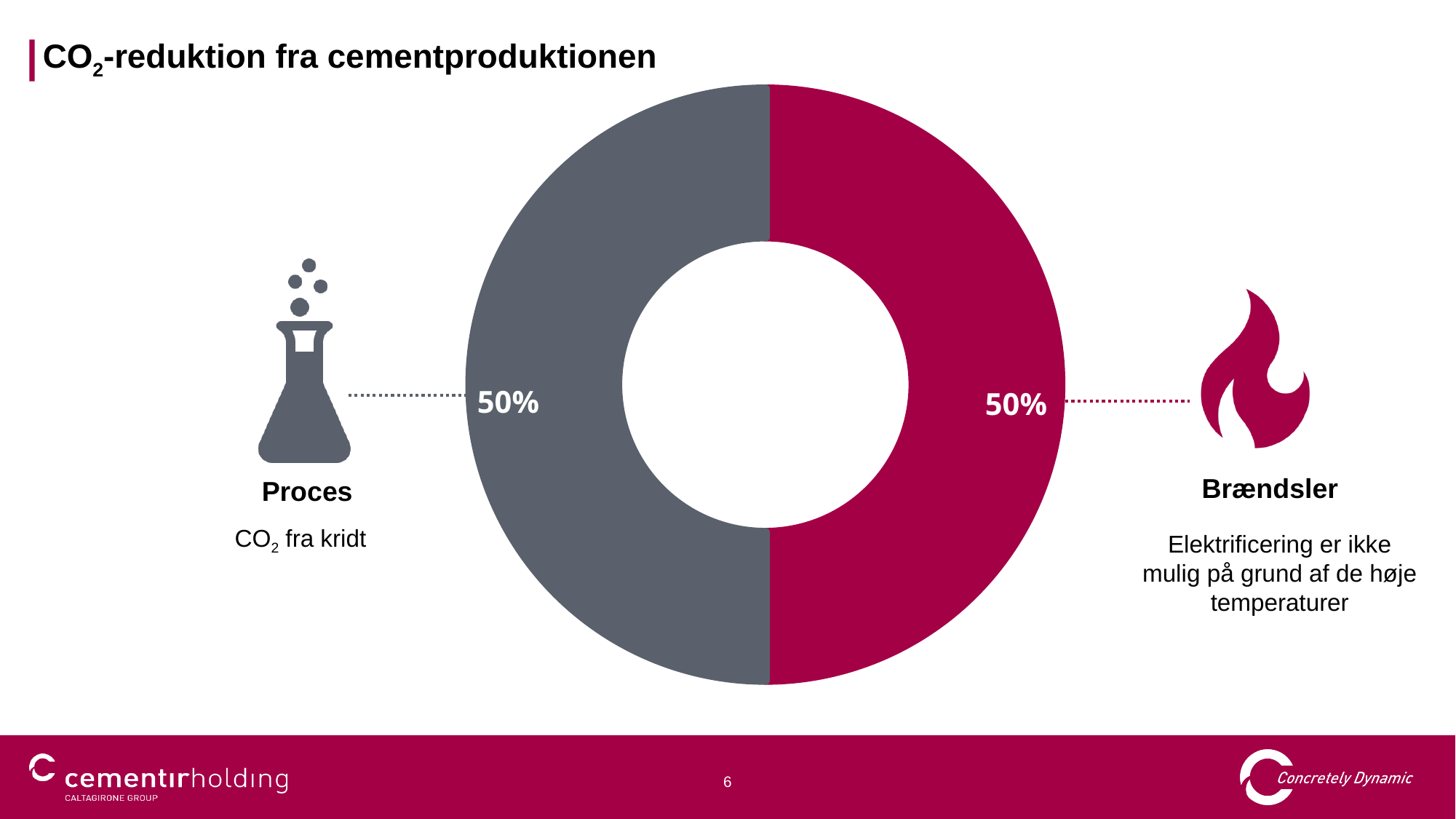
How many slices does the donut chart have? 2 Which colour is used for the Proces slice? Grey What kind of chart is shown on the slide? Donut (pie) chart What is the difference between the Proces share and the Brændsler share? 0% What do the Proces and Brændsler slices add up to? 100% What share of the donut chart does the Proces slice represent? 50% Which colour is used for the Brændsler slice? Red What share of the donut chart does the Brændsler slice represent? 50% Is the share for Proces greater or less than 75%? less Is the share for Brændsler greater or less than 25%? greater